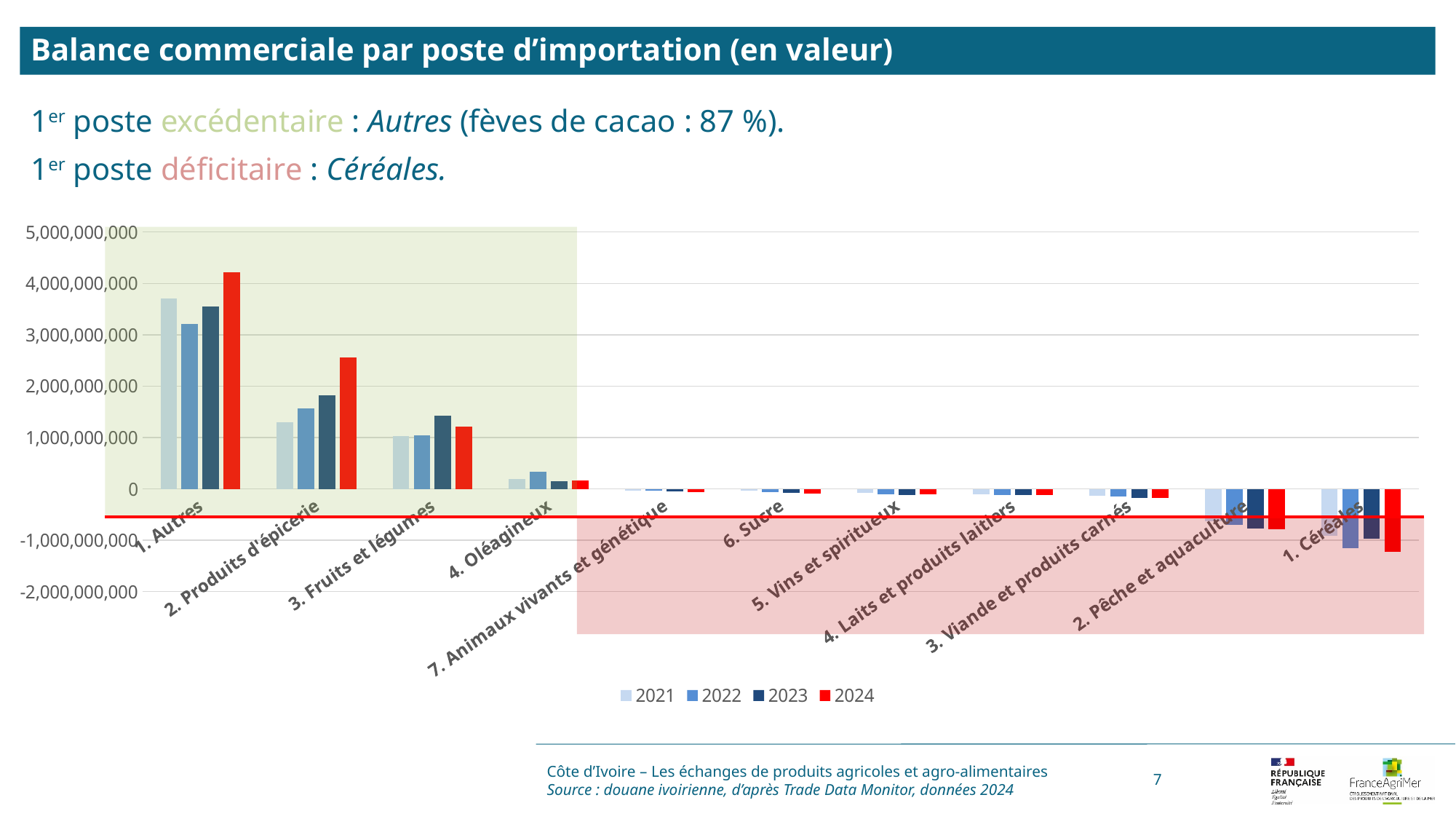
How many categories are shown on the x axis of the chart? 11 Is the 2024 value for 1. Céréales greater or less than -1,000,000,000? less Is the 2023 value for 3. Fruits et légumes greater or less than 1,000,000,000? greater How many series does the legend list? 4 Which colour represents the 2024 series in the legend? red What kind of chart is shown on the slide? bar chart Which category has the lowest 2024 value? 1. Céréales Which category has the highest 2024 value? 1. Autres Is the 2024 value for 1. Autres greater or less than 4,000,000,000? greater For 1. Autres, which is larger: the 2022 value or the 2024 value? 2024 For 2. Produits d'épicerie, do the values rise or fall from 2021 to 2024? rise